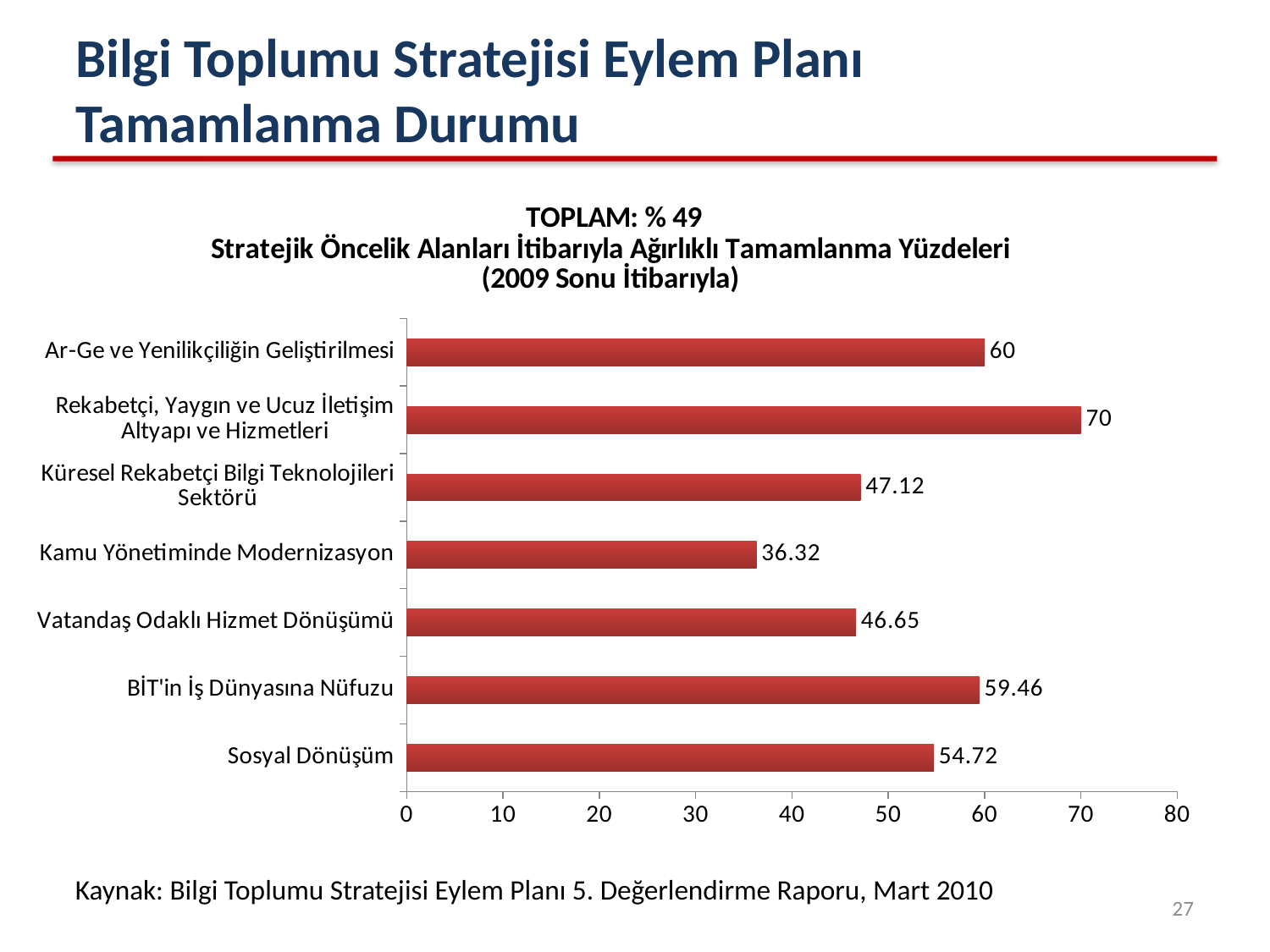
What is the value for Kamu Yönetiminde Modernizasyon? 36.32 How many categories are shown in the chart? 7 Which is larger, the value for Sosyal Dönüşüm or the value for Vatandaş Odaklı Hizmet Dönüşümü? Sosyal Dönüşüm Which category has the lowest value? Kamu Yönetiminde Modernizasyon What is the difference between the values for Küresel Rekabetçi Bilgi Teknolojileri Sektörü and Vatandaş Odaklı Hizmet Dönüşümü? 0.47 What is the value for BİT'in İş Dünyasına Nüfuzu? 59.46 Which category has the highest value? Rekabetçi, Yaygın ve Ucuz İletişim Altyapı ve Hizmetleri What kind of chart is shown on the slide? Bar chart What is the difference between the values for Rekabetçi, Yaygın ve Ucuz İletişim Altyapı ve Hizmetleri and Ar-Ge ve Yenilikçiliğin Geliştirilmesi? 10 What is the value for Sosyal Dönüşüm? 54.72 What is the value for Ar-Ge ve Yenilikçiliğin Geliştirilmesi? 60 What overall total percentage is stated above the chart? % 49